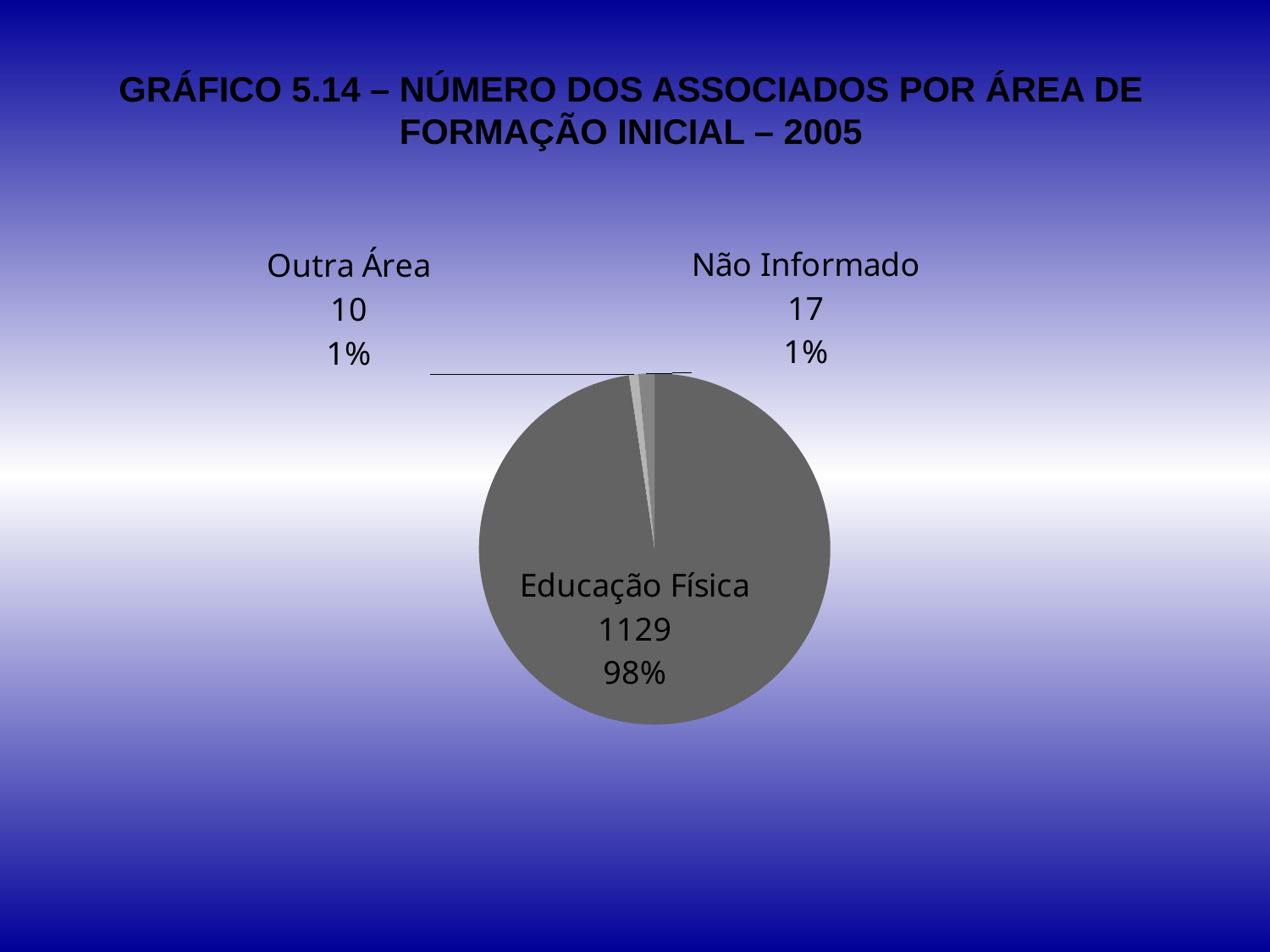
What share of the pie does Não Informado represent? 1% What is the title of the chart? GRÁFICO 5.14 – NÚMERO DOS ASSOCIADOS POR ÁREA DE FORMAÇÃO INICIAL – 2005 What share of the pie does Educação Física represent? 98% What kind of chart is shown on the slide? pie chart What is the difference between the values for Não Informado and Outra Área? 7 What is the value for Educação Física? 1129 Which is larger, the value for Não Informado or the value for Outra Área? Não Informado What is the value for Não Informado? 17 Which category has the smallest value? Outra Área What is the value for Outra Área? 10 How many slices does the pie chart have? 3 Which category has the largest slice? Educação Física